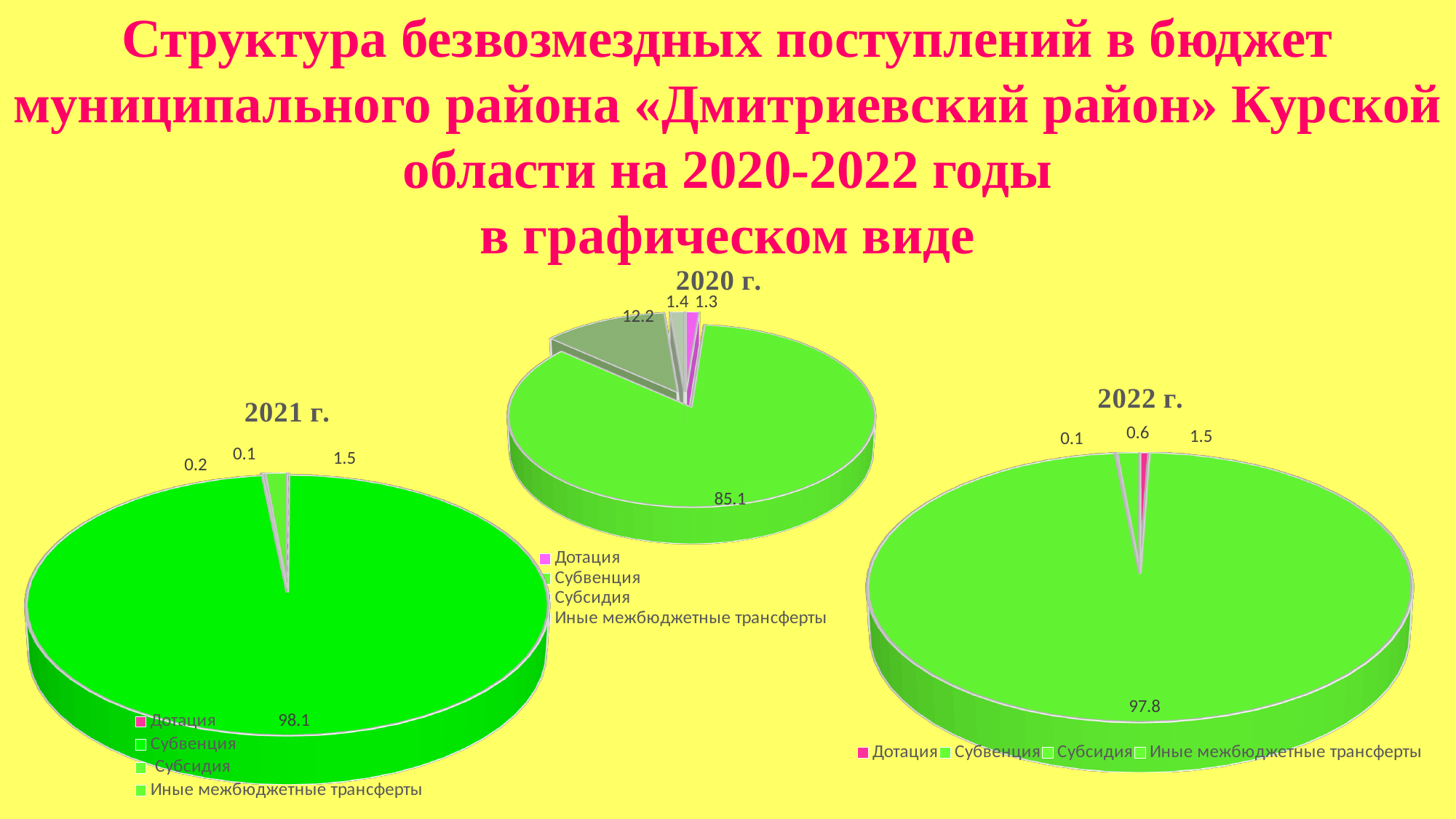
In the 2021 г. chart, what is the value of the smallest slice? 0.1 In the 2020 г. chart, what is the difference between the largest slice (85.1) and the second largest slice (12.2)? 72.9 In the 2022 г. chart, what is the value of the largest slice? 97.8 What is the first entry listed in the legend of the 2022 г. chart? Дотация Which chart has the larger value for its largest slice, 2021 г. or 2022 г.? 2021 г. In the 2020 г. chart, what is the value of the second largest slice? 12.2 How many pie charts are on the slide? 3 In the 2020 г. chart, what is the value of the smallest slice? 1.3 In the 2021 г. chart, what is the value of the largest slice? 98.1 How many entries does the legend of the 2020 г. chart list? 4 In the 2020 г. chart, what is the value of the largest slice? 85.1 What kind of charts are shown on the slide? Pie charts